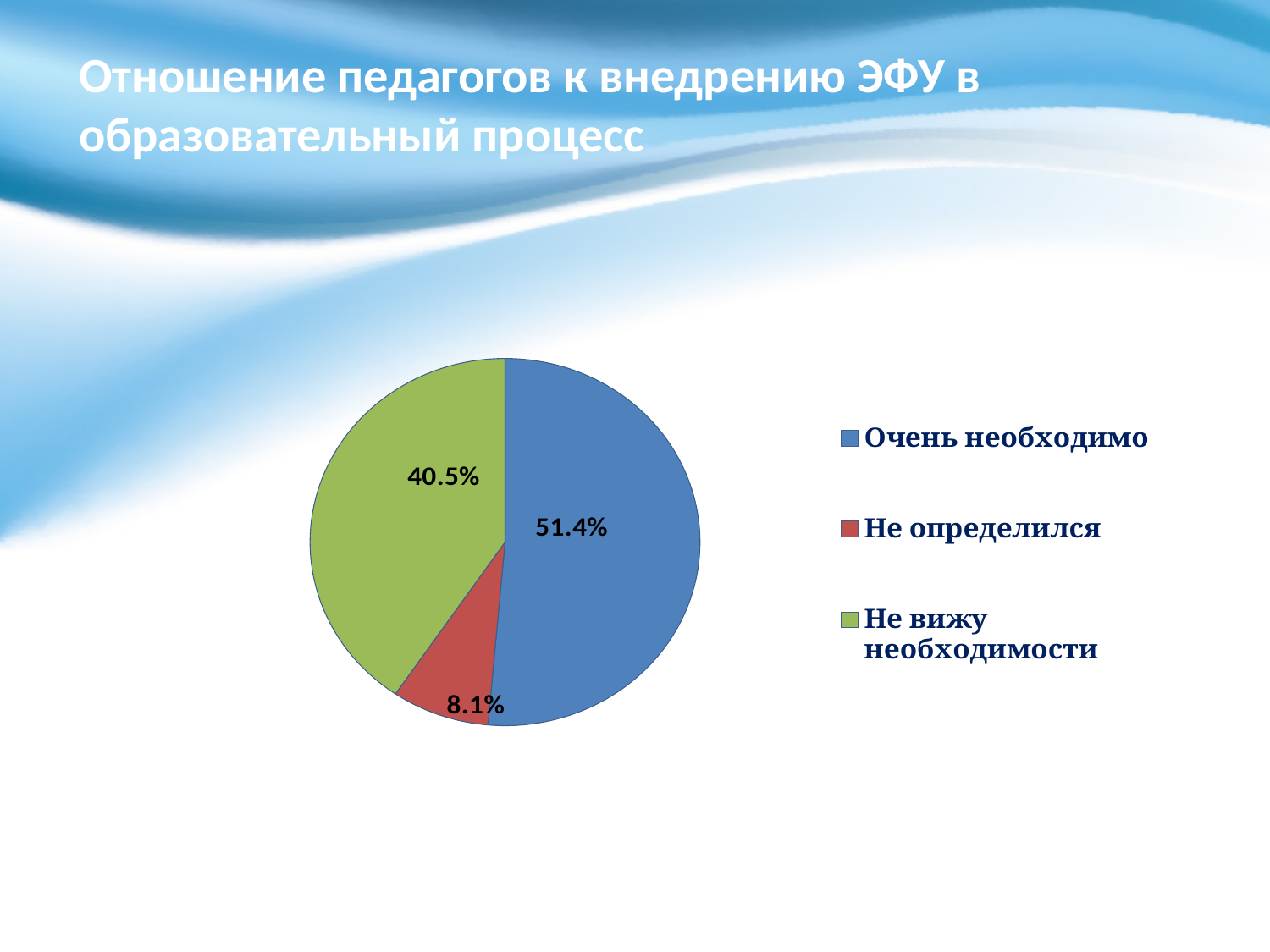
Which legend entry is shown in green? Не вижу необходимости What is the value shown for "Не определился"? 8.1% Which category has the smallest slice of the pie? Не определился Which category has the largest slice of the pie? Очень необходимо What is the difference between the values for "Не вижу необходимости" and "Не определился"? 32.4% What is the value shown for "Не вижу необходимости"? 40.5% What colour is the slice for "Не определился"? Red What kind of chart is shown on the slide? Pie chart What is the difference between the values for "Очень необходимо" and "Не вижу необходимости"? 10.9% How many categories does the pie chart show? 3 What share of the pie does "Очень необходимо" take? 51.4% Which is larger, the slice for "Очень необходимо" or the slice for "Не вижу необходимости"? Очень необходимо